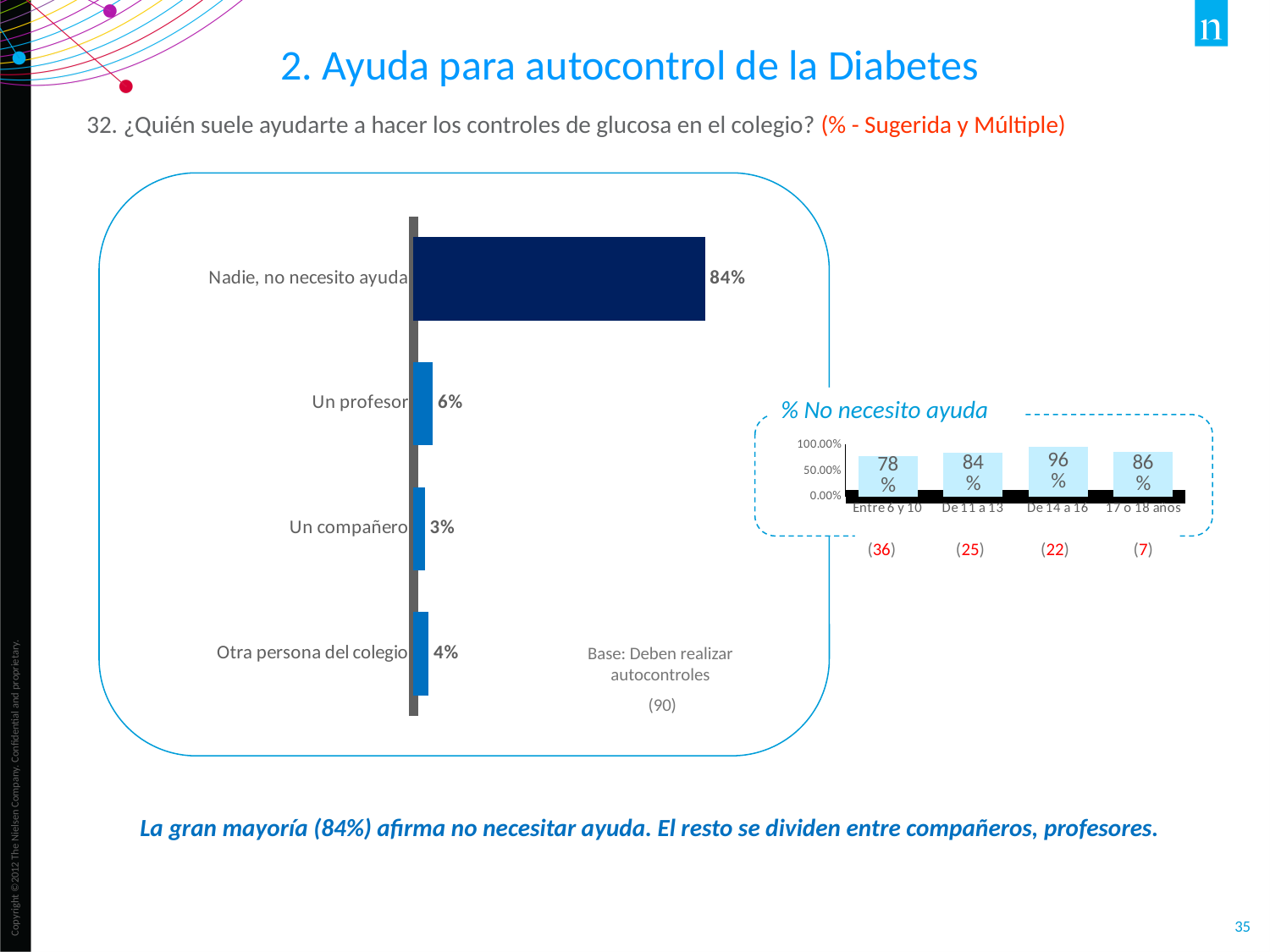
In the main horizontal bar chart, what is the value for 'Un compañero'? 3% In the main horizontal bar chart, what is the value for 'Nadie, no necesito ayuda'? 84% What kind of chart is the main chart on the left? Bar chart In the '% No necesito ayuda' chart, what is the value for 'De 14 a 16'? 96% In the main horizontal bar chart, what is the value for 'Un profesor'? 6% In the main horizontal bar chart, which category has the lowest value? Un compañero In the '% No necesito ayuda' chart, which is larger: 'De 11 a 13' or '17 o 18 años'? 17 o 18 años In the main horizontal bar chart, what is the difference between 'Nadie, no necesito ayuda' and 'Un profesor'? 78% In the main horizontal bar chart, which category has the highest value? Nadie, no necesito ayuda In the '% No necesito ayuda' chart, which age group has the lowest value? Entre 6 y 10 In the main horizontal bar chart, how many categories are shown? 4 In the '% No necesito ayuda' chart, what is the value for 'Entre 6 y 10'? 78%